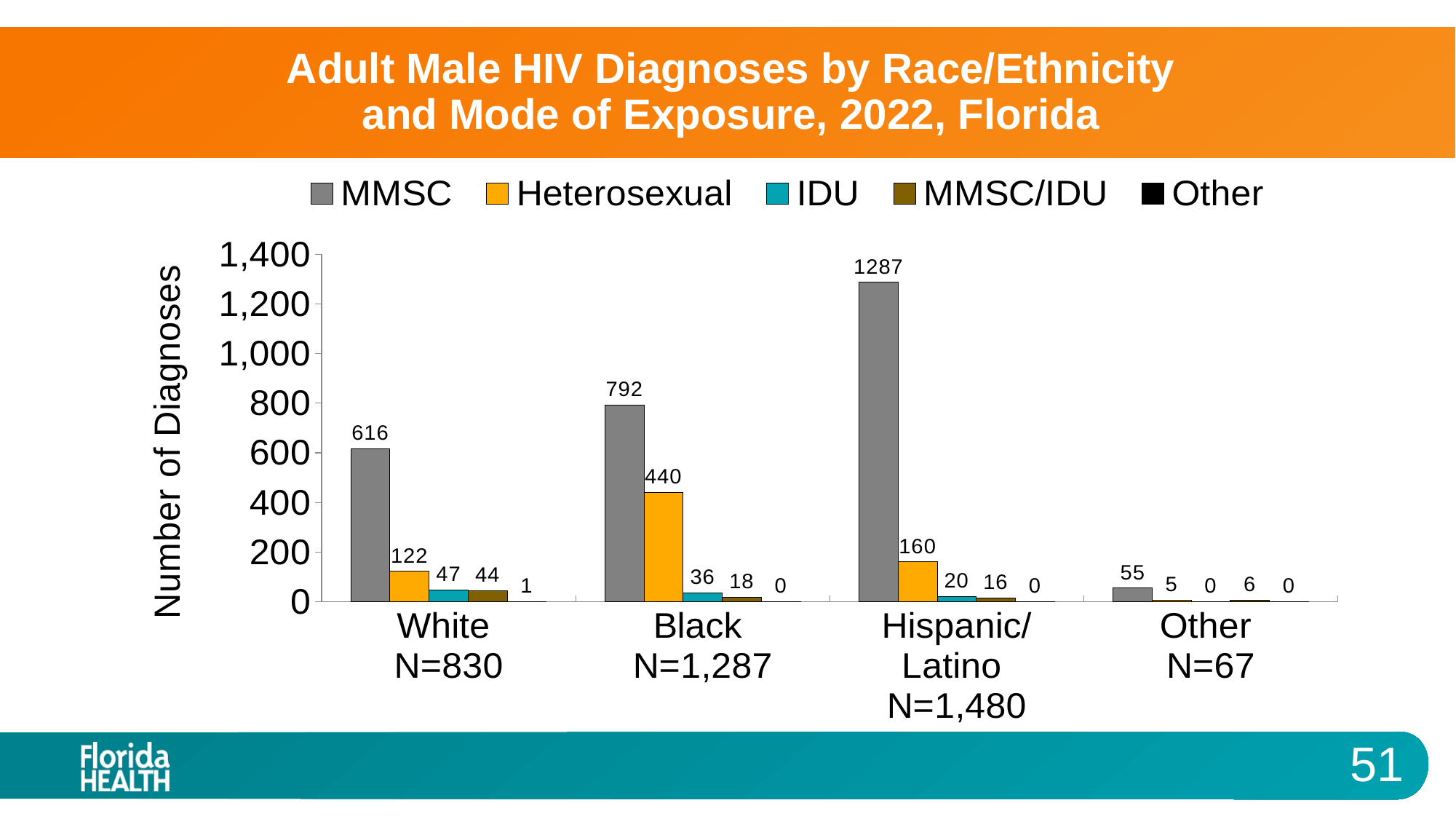
What is the number of MMSC diagnoses for Hispanic/Latino adult males? 1287 How many race/ethnicity categories are shown on the x axis? 4 What is the number of IDU diagnoses for White adult males? 47 What is the number of Heterosexual diagnoses for Black adult males? 440 What is the difference between the MMSC values for Black and White adult males? 176 What is the MMSC/IDU value for the Other race/ethnicity group? 6 What kind of chart is shown on the slide? Bar chart Which race/ethnicity group has the lowest Heterosexual value? Other What is the label of the y axis? Number of Diagnoses How many series does the legend list? 5 Which is larger, the Heterosexual value for White or for Hispanic/Latino? Hispanic/Latino Which race/ethnicity group has the highest MMSC value? Hispanic/Latino